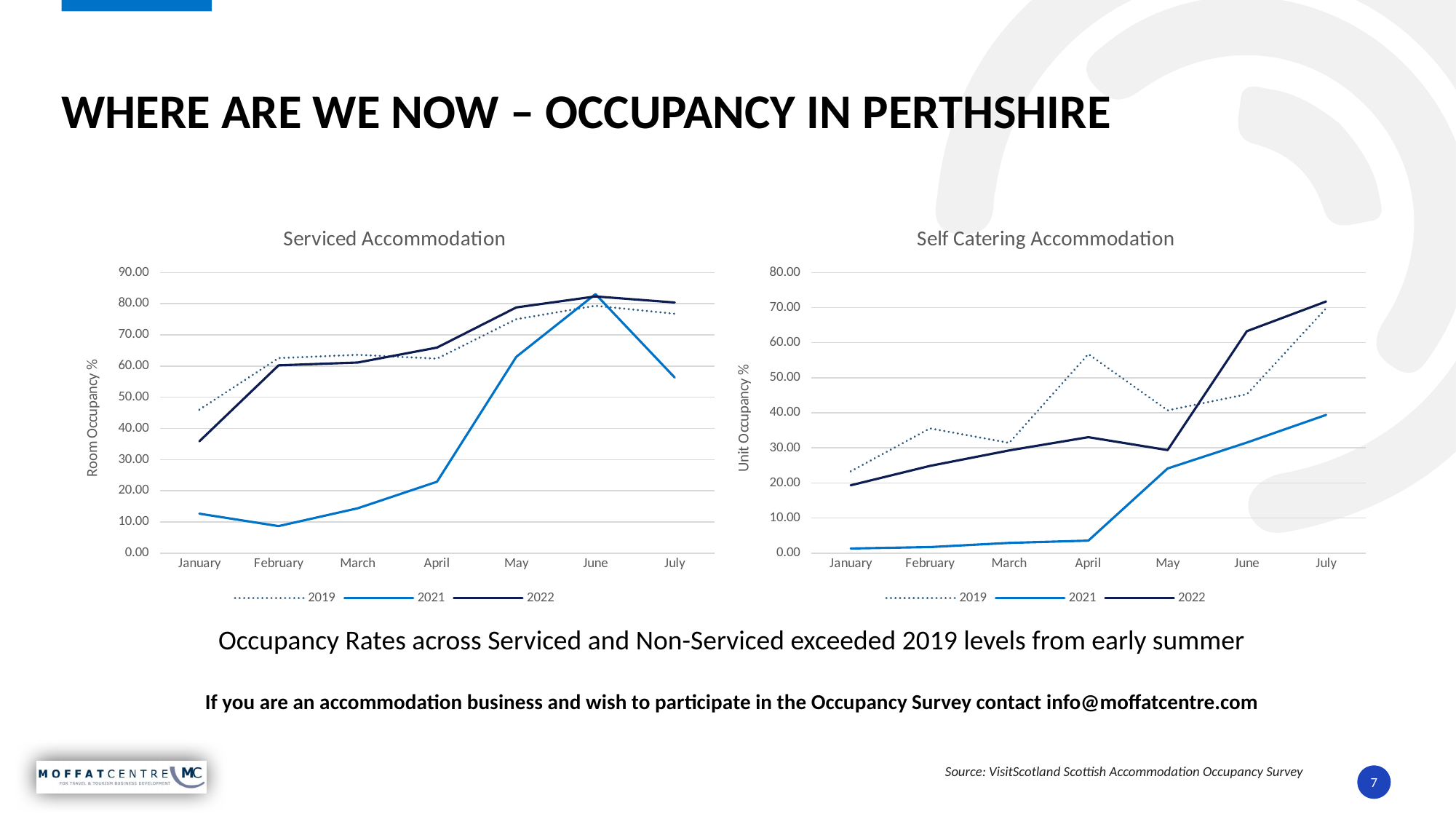
How many months are shown on the x axis of the Serviced Accommodation chart? 7 What kind of chart is the Serviced Accommodation chart? Line chart In the Self Catering Accommodation chart, does the 2021 series rise or fall from January to July? rise In the Self Catering Accommodation chart, which series has the larger value in June, 2019 or 2022? 2022 What is the y-axis title of the Self Catering Accommodation chart? Unit Occupancy % In the Self Catering Accommodation chart, is the 2021 value for July greater or less than 30.00? greater In the Serviced Accommodation chart, is the 2022 value for May greater or less than 70.00? greater In the Self Catering Accommodation chart, which month has the highest 2019 value? July How many series does the legend of the Self Catering Accommodation chart list? 3 In the Self Catering Accommodation chart, which month has the lowest 2022 value? January In the Serviced Accommodation chart, is the 2021 value for January greater or less than 20.00? less In the Serviced Accommodation chart, which month has the lowest 2021 value? February